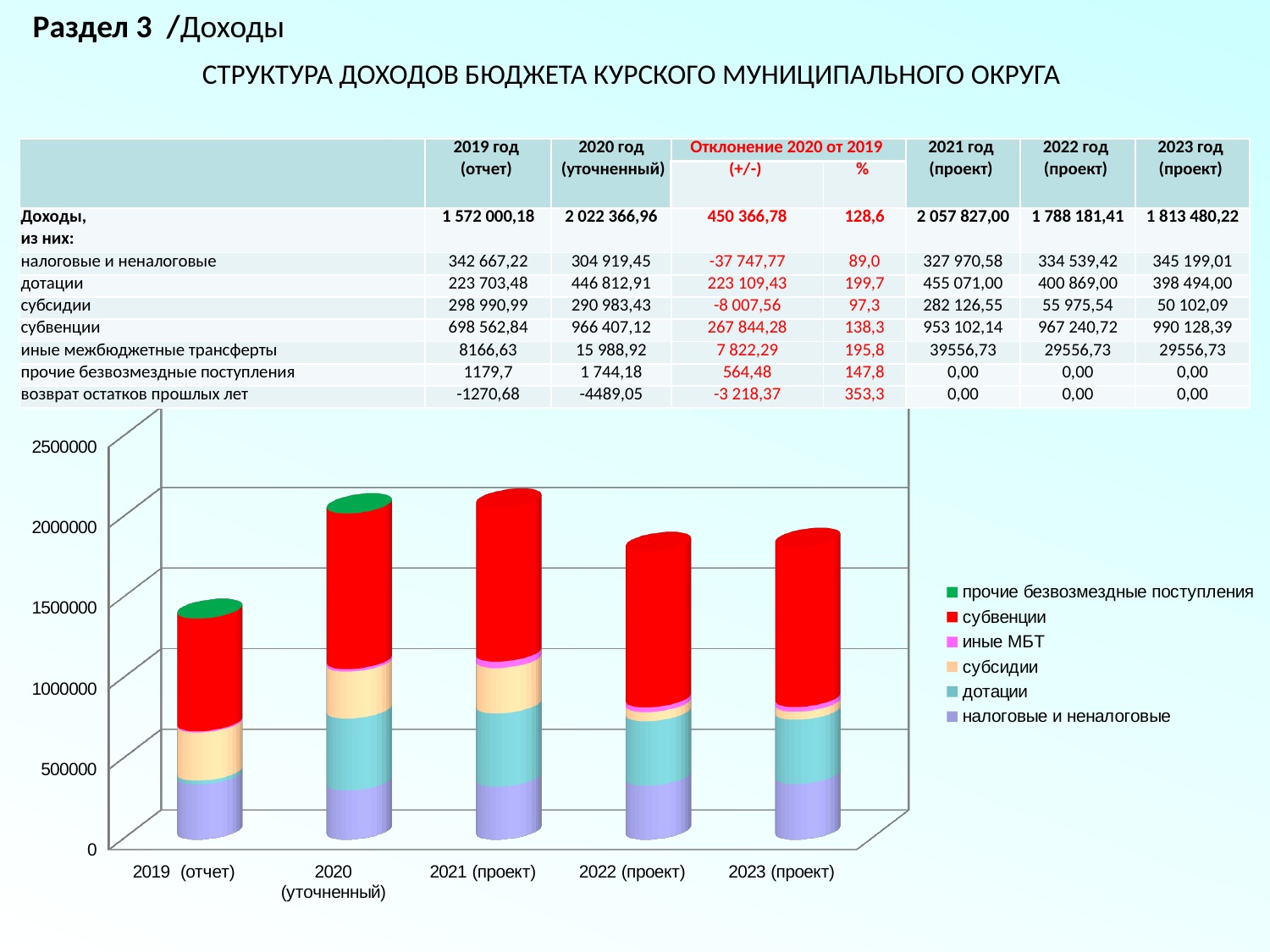
What kind of chart is shown on the slide? stacked bar chart How many categories (years) are shown on the x axis of the chart? 5 Does the total bar rise or fall from 2021 (проект) to 2022 (проект)? fall Which series forms the bottom segment of each stacked bar? налоговые и неналоговые Which total bar is larger, 2019 (отчет) or 2021 (проект)? 2021 (проект) Is the total bar for 2019 (отчет) greater or less than 2000000? less Is the total bar for 2021 (проект) greater or less than 1500000? greater Which total bar is larger, 2019 (отчет) or 2022 (проект)? 2022 (проект) Which series is shown in red in the chart legend? субвенции How many series does the chart legend list? 6 Is the total bar for 2022 (проект) greater or less than 2000000? less Which year has the lowest total bar in the chart? 2019 (отчет)